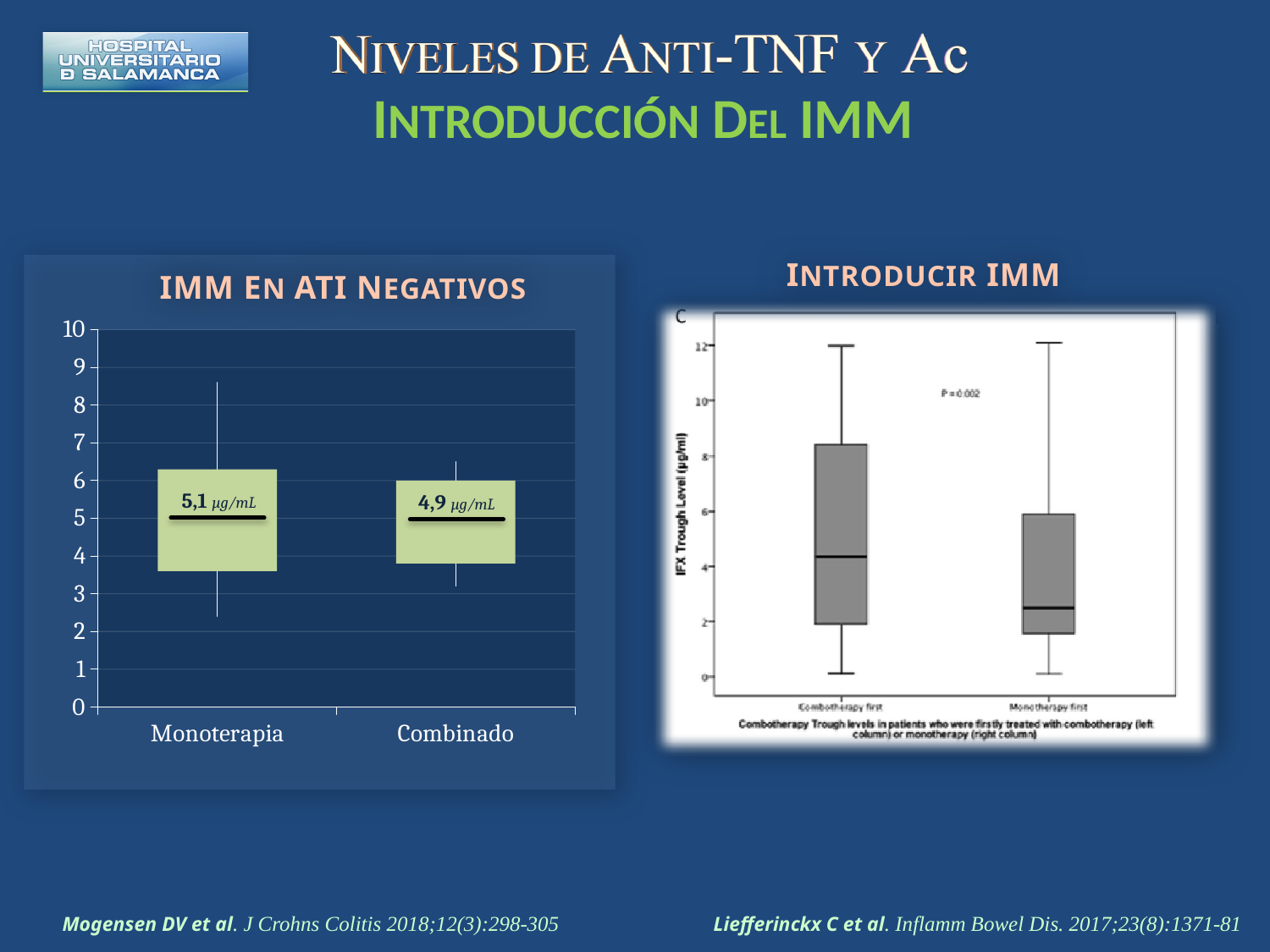
In the 'IMM En ATI Negativos' chart, what value is labelled for Combinado? 4,9 µg/mL What kind of chart is the 'IMM En ATI Negativos' chart? Box plot How many groups are shown on the x axis of the 'IMM En ATI Negativos' chart? 2 In the 'IMM En ATI Negativos' chart, what is the difference between the labelled values for Monoterapia and Combinado? 0,2 µg/mL What is the y-axis label of the 'Introducir IMM' chart? IFX Trough Level (µg/ml) In the 'Introducir IMM' chart, which group has the higher median IFX trough level, Combotherapy first or Monotherapy first? Combotherapy first In the 'IMM En ATI Negativos' chart, what value is labelled for Monoterapia? 5,1 µg/mL In the 'Introducir IMM' chart, what P value is printed on the plot? P = 0.002 In the 'IMM En ATI Negativos' chart, is the top of the upper whisker for Monoterapia greater or less than 8? greater In the 'IMM En ATI Negativos' chart, is the bottom of the lower whisker for Monoterapia greater or less than 3? less What is the maximum value shown on the y axis of the 'IMM En ATI Negativos' chart? 10 In the 'IMM En ATI Negativos' chart, which group has the higher labelled value, Monoterapia or Combinado? Monoterapia